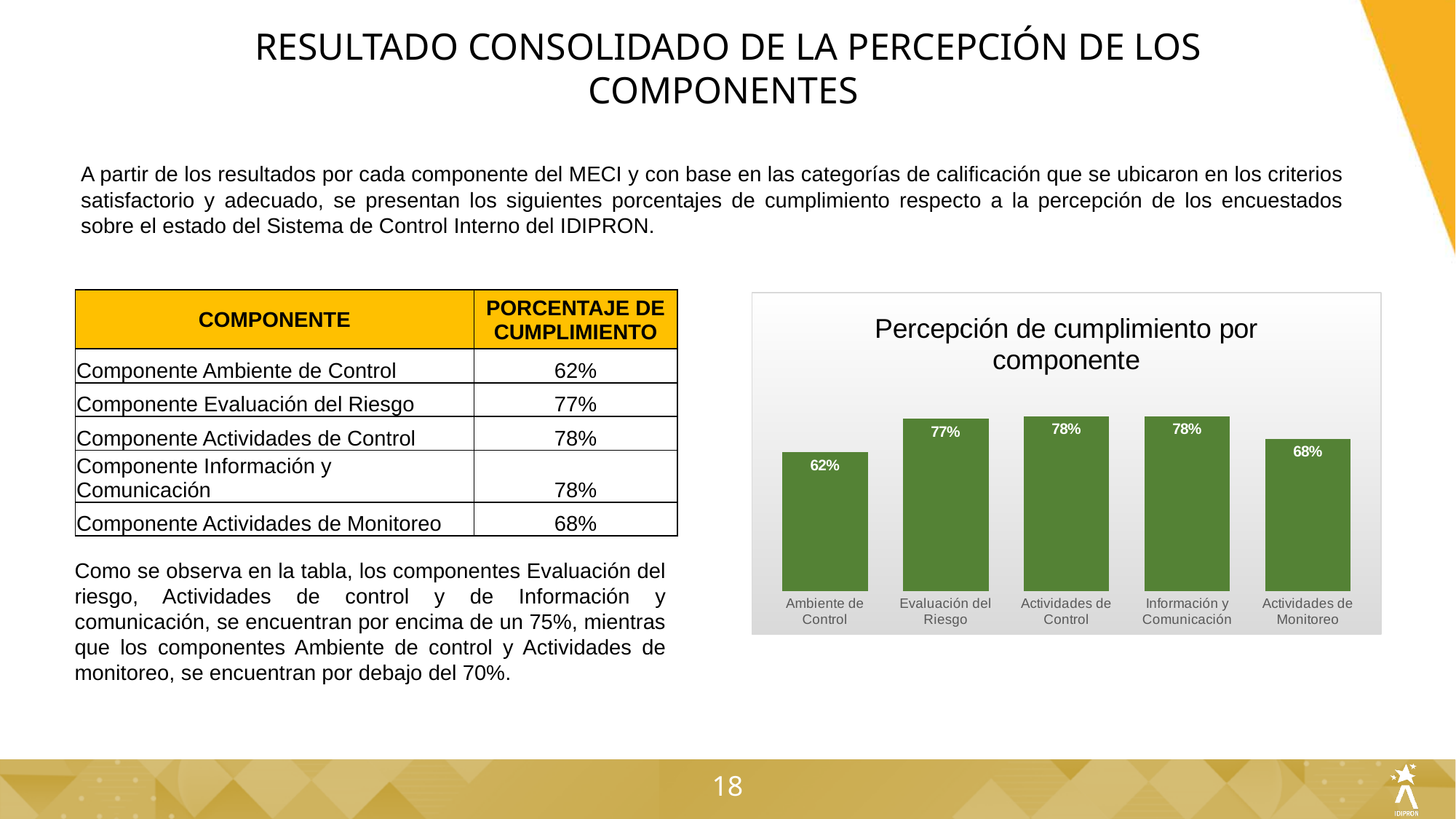
What is the value for Actividades de Monitoreo in the chart? 68% How many categories are shown in the chart? 5 Which is larger, the value for Evaluación del Riesgo or the value for Actividades de Monitoreo? Evaluación del Riesgo What kind of chart is shown on the slide? Bar chart Which category has the lowest value in the chart? Ambiente de Control What is the value for Evaluación del Riesgo in the chart? 77% What is the title of the chart? Percepción de cumplimiento por componente What is the difference between the values for Evaluación del Riesgo and Ambiente de Control? 15% What colour are the bars in the chart? Green What is the value for Ambiente de Control in the chart? 62% What is the value for Información y Comunicación in the chart? 78% What is the difference between the values for Actividades de Control and Actividades de Monitoreo? 10%